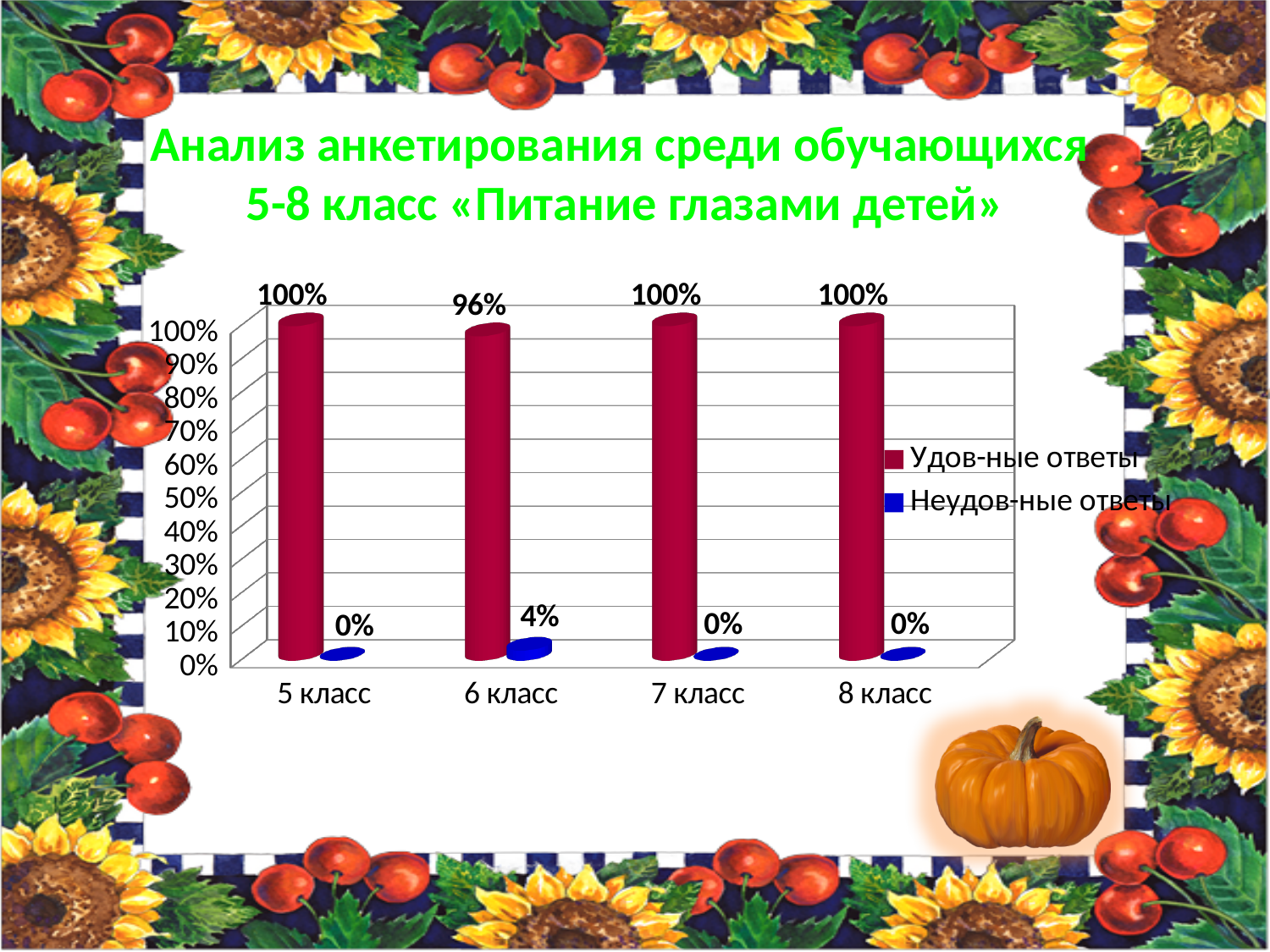
Is the value of «Удов-ные ответы» for 6 класс greater or less than 90%? greater What is the value of «Удов-ные ответы» for 5 класс? 100% What is the value of «Удов-ные ответы» for 6 класс? 96% Which is larger for 7 класс: «Удов-ные ответы» or «Неудов-ные ответы»? Удов-ные ответы What is the value of «Неудов-ные ответы» for 8 класс? 0% Which class has the lowest value for «Удов-ные ответы»? 6 класс What kind of chart is shown on the slide? bar chart What is the difference between «Удов-ные ответы» and «Неудов-ные ответы» for 6 класс? 92% What is the value of «Неудов-ные ответы» for 6 класс? 4% How many series does the legend list? 2 How many classes (categories) are shown on the x axis? 4 Which class has the highest value for «Неудов-ные ответы»? 6 класс